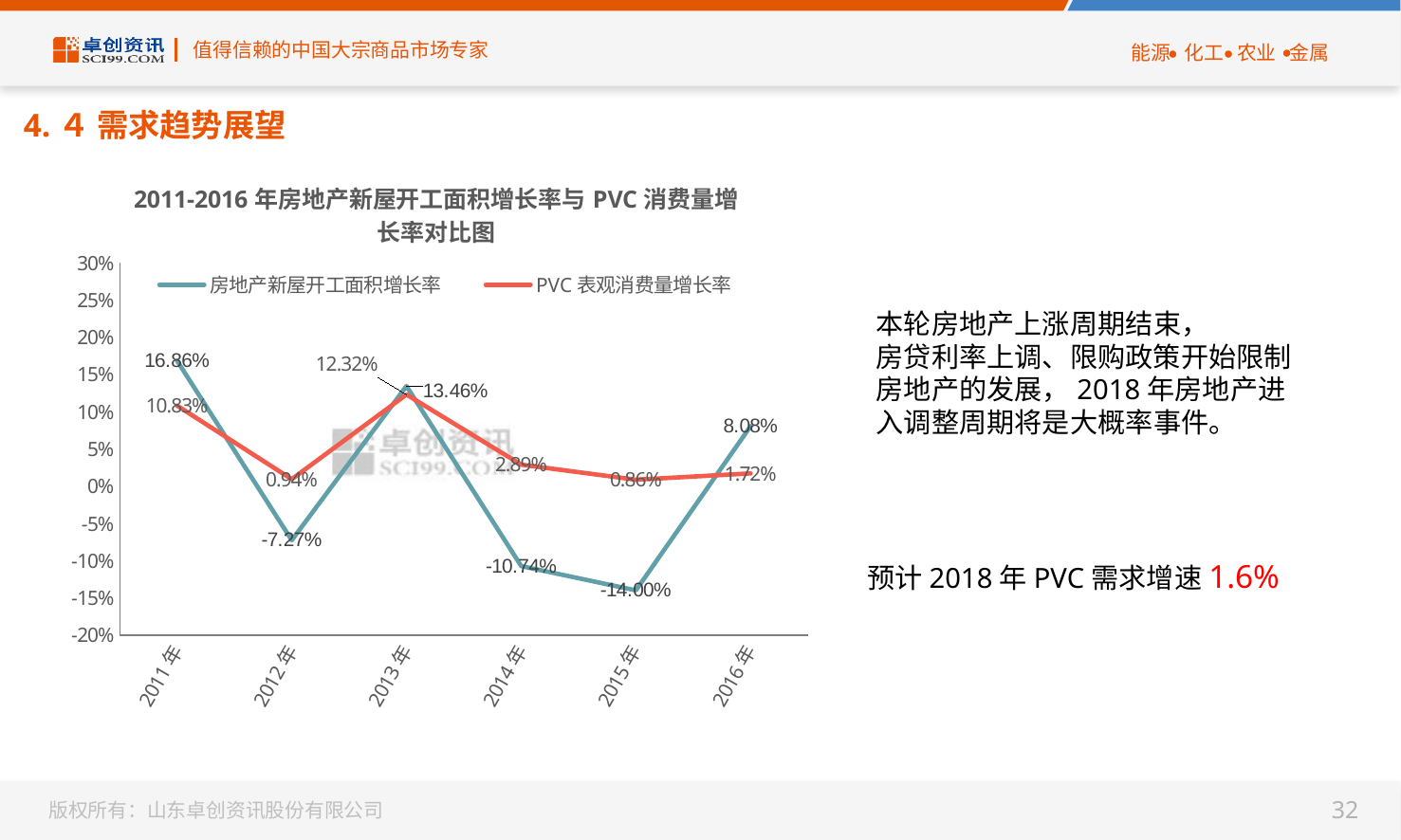
What is the difference between the 房地产新屋开工面积增长率 and the PVC 表观消费量增长率 in 2011 年? 6.03% What is the 房地产新屋开工面积增长率 value for 2015 年? -14.00% In which year is the 房地产新屋开工面积增长率 lowest? 2015 年 What is the PVC 表观消费量增长率 value for 2012 年? 0.94% In 2012 年, which series has the larger value, 房地产新屋开工面积增长率 or PVC 表观消费量增长率? PVC 表观消费量增长率 How many years are plotted along the x axis of the chart? 6 Does the PVC 表观消费量增长率 rise or fall from 2013 年 to 2015 年? fall How many series does the chart legend list? 2 In which year is the 房地产新屋开工面积增长率 highest? 2011 年 What kind of chart is shown on the slide? line chart What is the 房地产新屋开工面积增长率 value for 2011 年? 16.86% What is the PVC 表观消费量增长率 value for 2016 年? 1.72%